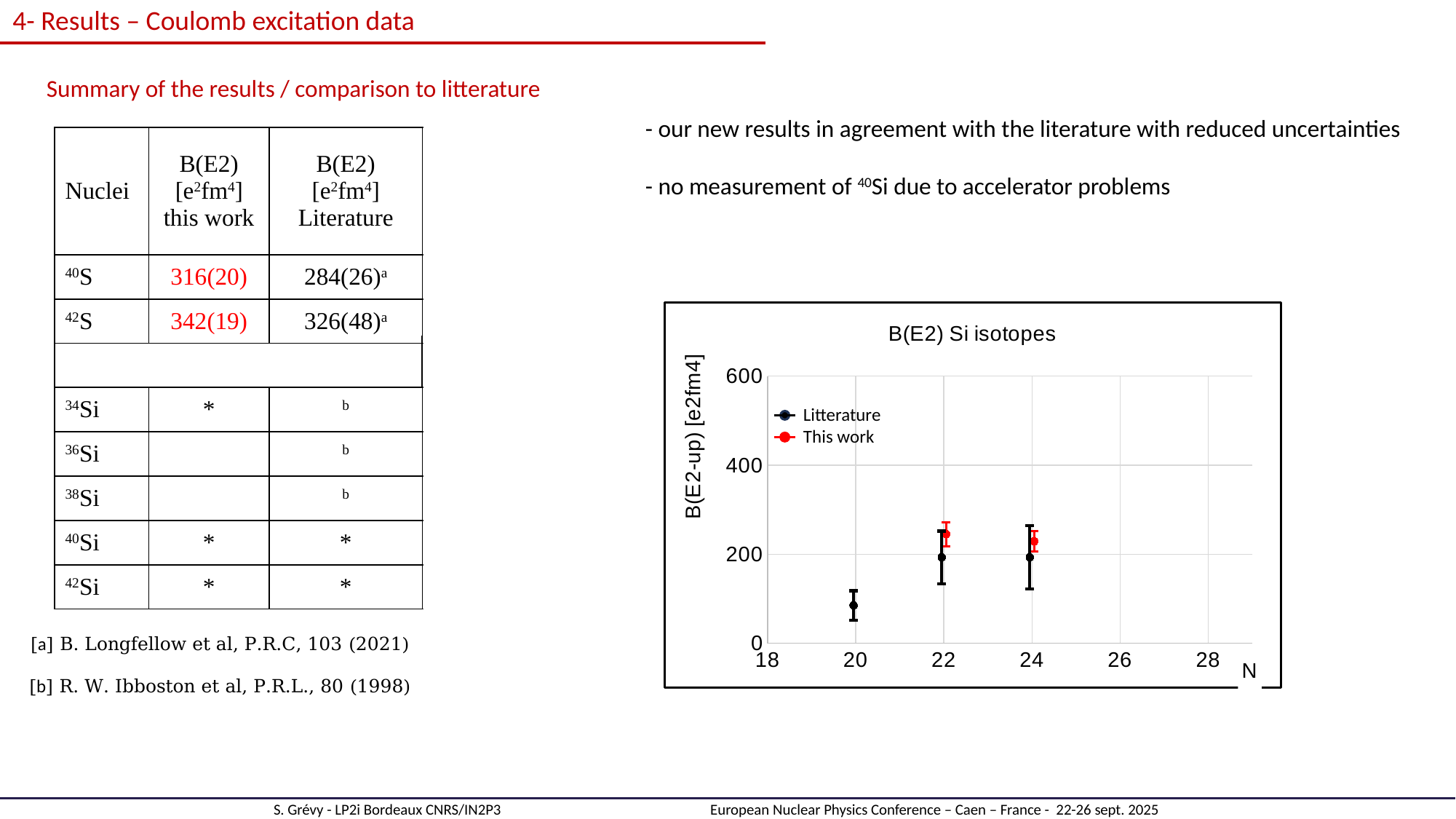
How many data points are plotted for the This work series? 2 Does the Litterature series rise or fall from N = 20 to N = 22? rise At which value of N is the lowest Litterature point plotted? 20 Which series is plotted in red in the B(E2) Si isotopes chart? This work At N = 22, which series has the larger value, Litterature or This work? This work How many data points are plotted for the Litterature series? 3 Is the Litterature value at N = 22 greater or less than 400? less Is the Litterature value at N = 20 greater or less than 200? less Is the This work value at N = 22 greater or less than 200? greater What is the title of the chart on the slide? B(E2) Si isotopes What kind of chart is shown on the slide? scatter chart How many series does the legend of the B(E2) Si isotopes chart list? 2